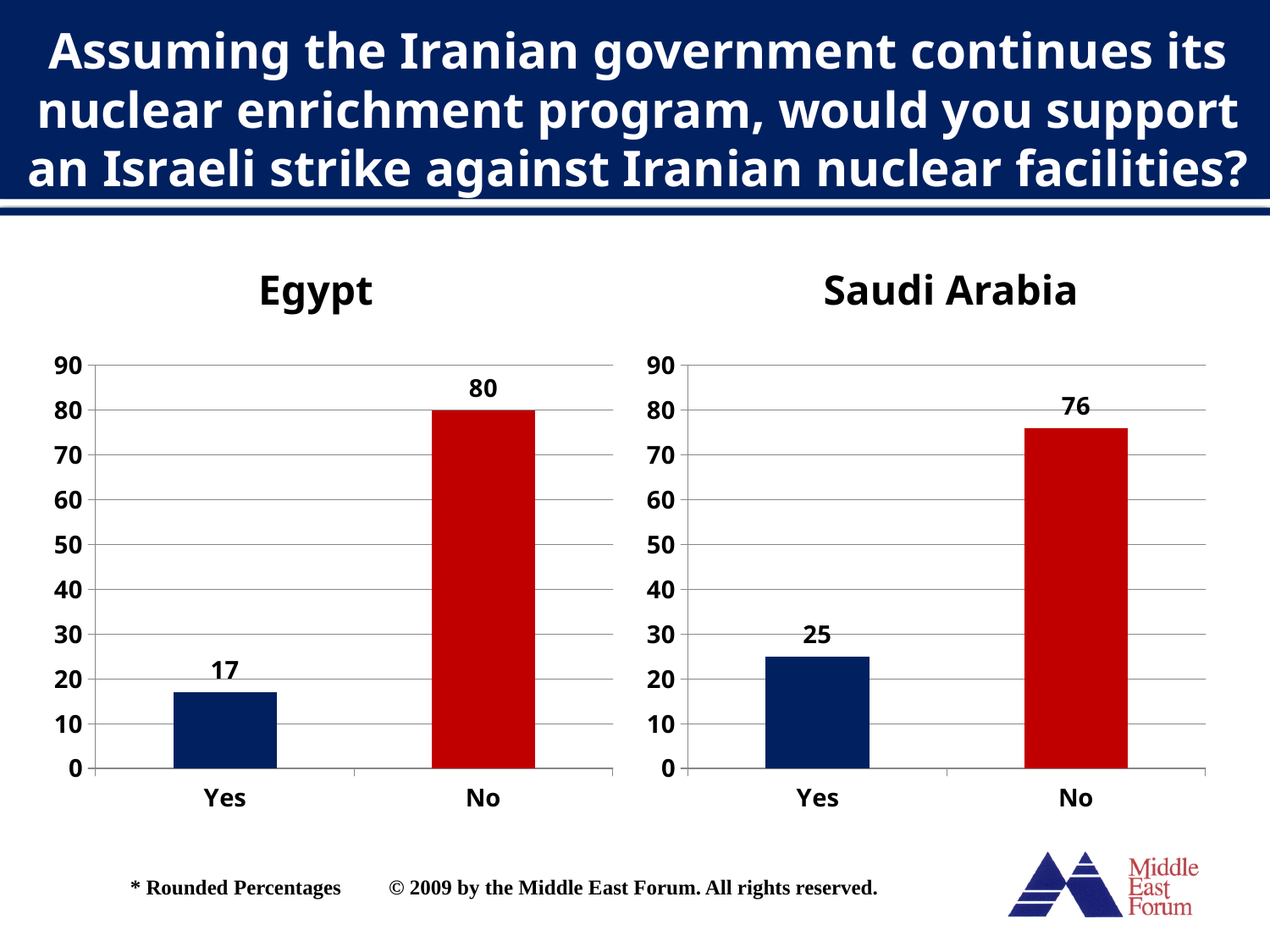
How many categories are shown in the Egypt chart? 2 In the Saudi Arabia chart, what is the value for Yes? 25 In the Egypt chart, what is the value for Yes? 17 In the Saudi Arabia chart, what is the difference between the No and Yes values? 51 What kind of chart is the Saudi Arabia chart? bar chart Which chart has the larger value for Yes, Egypt or Saudi Arabia? Saudi Arabia In the Saudi Arabia chart, what is the value for No? 76 In the Saudi Arabia chart, is the value for No greater or less than 70? greater In the Egypt chart, which category has the highest value? No In the Saudi Arabia chart, which category has the lowest value? Yes In the Egypt chart, what is the value for No? 80 In the Egypt chart, what is the difference between the No and Yes values? 63